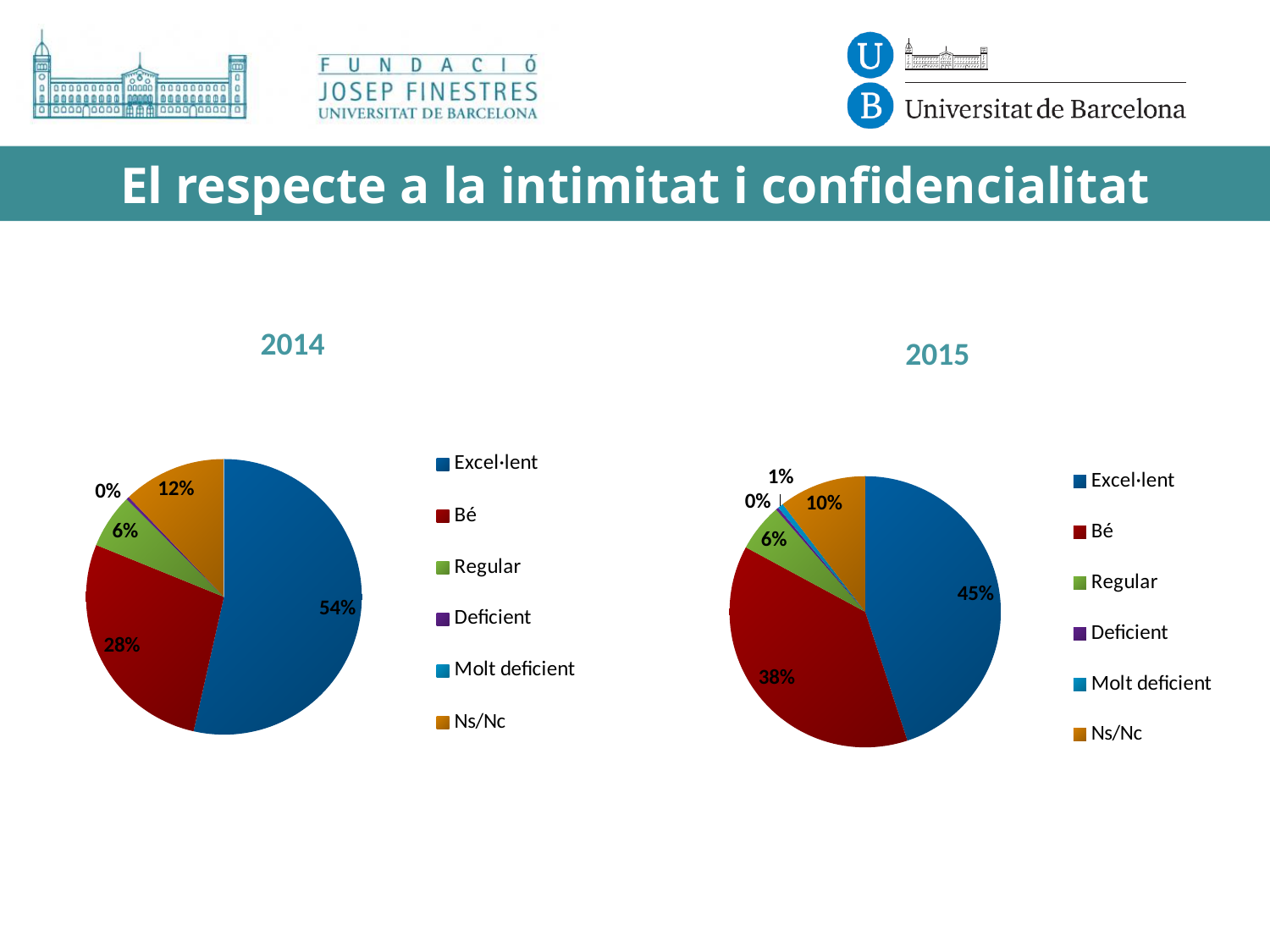
In the 2015 chart, what percentage is shown for Molt deficient? 1% In the 2015 chart, what percentage is shown for Ns/Nc? 10% In the 2014 chart, what percentage is shown for Excel·lent? 54% In the 2014 chart, what percentage is shown for Regular? 6% In the 2014 chart, which category has the largest slice? Excel·lent In the 2015 chart, what percentage is shown for Bé? 38% How many categories does the legend of the 2015 chart list? 6 In the 2015 chart, which category has the largest slice? Excel·lent In the 2014 chart, what is the combined share of Excel·lent and Bé? 82% What type of chart is used for the 2014 data? Pie chart Which is larger: the Bé share in the 2014 chart or in the 2015 chart? 2015 What is the difference between the Excel·lent share in 2014 and in 2015? 9%